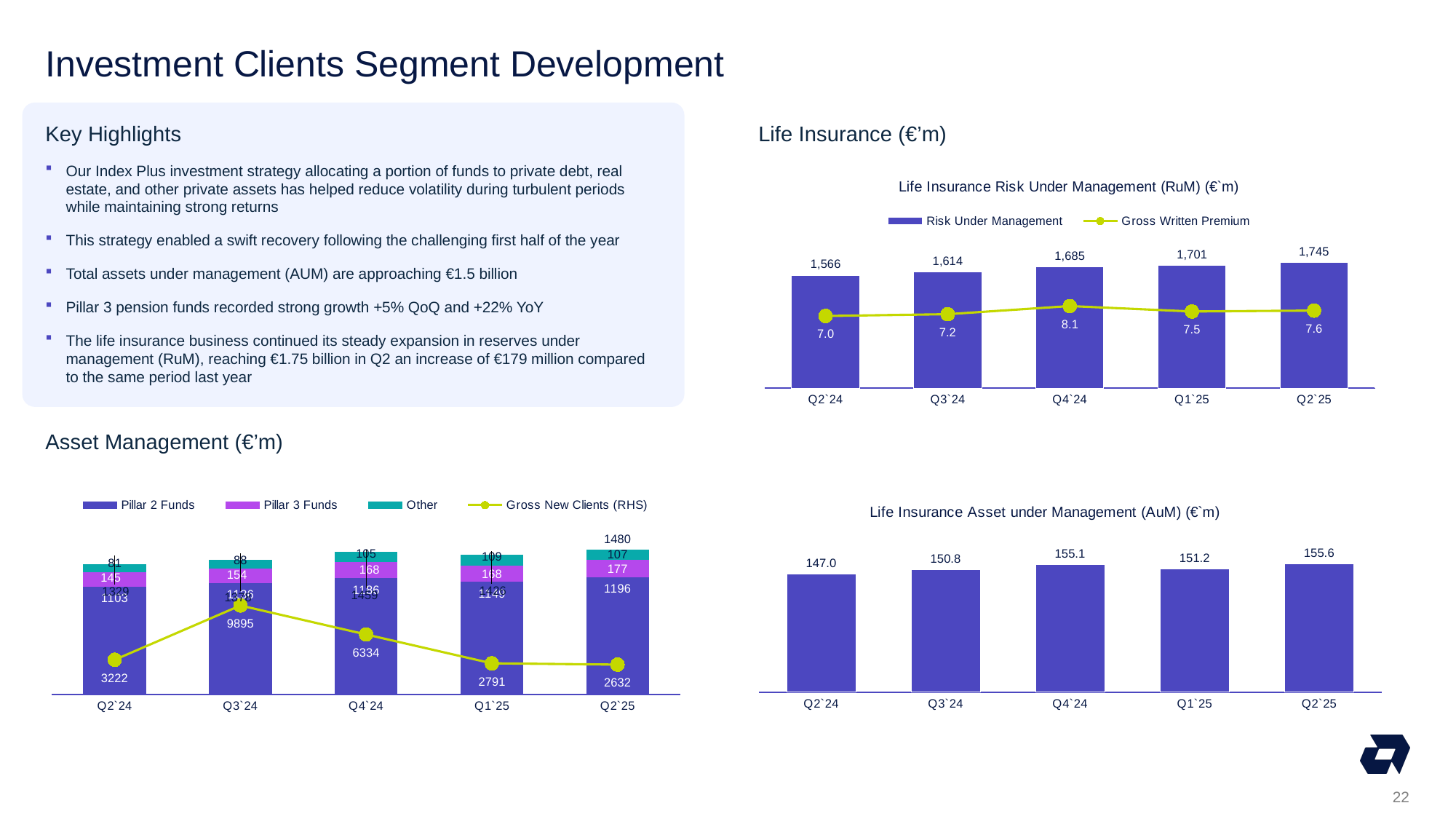
In the Life Insurance Risk Under Management (RuM) chart, what is the difference in Risk Under Management between Q2`25 and Q2`24? 179 In the Life Insurance Asset under Management (AuM) chart, what is the value for Q3`24? 150.8 In the Life Insurance Risk Under Management (RuM) chart, do the Risk Under Management values rise or fall from Q2`24 to Q2`25? rise In the Asset Management chart, what is the Pillar 3 Funds value for Q2`25? 177 In the Life Insurance Asset under Management (AuM) chart, is the value for Q4`24 or Q1`25 larger? Q4`24 In the Life Insurance Risk Under Management (RuM) chart, how many series does the legend list? 2 In the Life Insurance Risk Under Management (RuM) chart, what is the Gross Written Premium for Q4`24? 8.1 In the Asset Management chart, what is the Gross New Clients value for Q3`24? 9895 In the Life Insurance Asset under Management (AuM) chart, which quarter has the highest value? Q2`25 In the Life Insurance Risk Under Management (RuM) chart, what is the Risk Under Management value for Q2`25? 1,745 In the Asset Management chart, how many quarters are shown on the x axis? 5 In the Life Insurance Risk Under Management (RuM) chart, which quarter has the lowest Risk Under Management? Q2`24